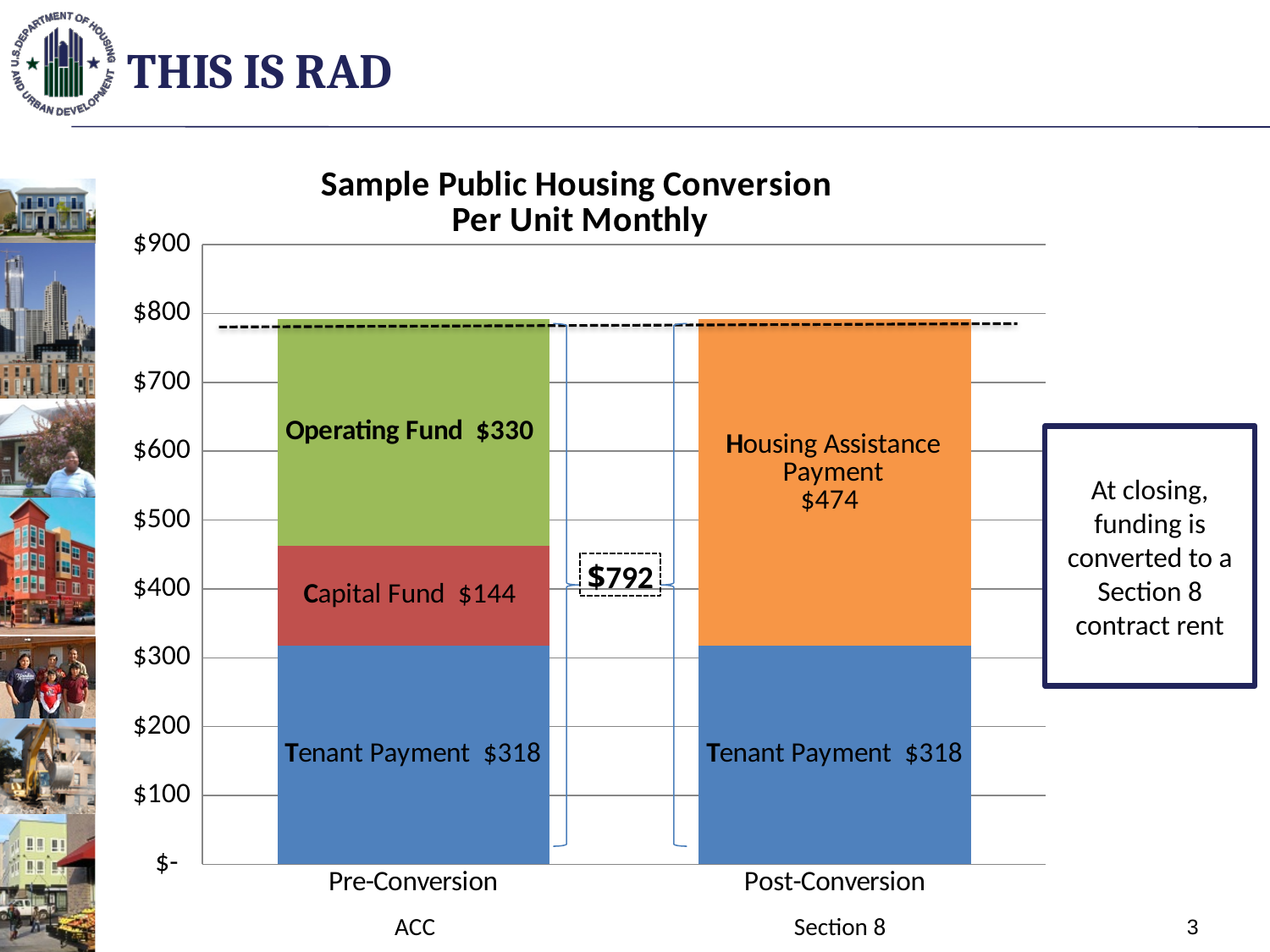
What is the Tenant Payment value in the Post-Conversion bar? $318 What kind of chart is shown on the slide? stacked bar chart Which segment of the Pre-Conversion bar is the smallest? Capital Fund What is the difference between the Operating Fund ($330) and the Capital Fund ($144) in the Pre-Conversion bar? $186 What is the Housing Assistance Payment value in the Post-Conversion bar? $474 What is the total of the Post-Conversion stacked bar? $792 What is the title of the chart? Sample Public Housing Conversion Per Unit Monthly Which is larger in the Post-Conversion bar: Housing Assistance Payment or Tenant Payment? Housing Assistance Payment What is the Capital Fund value in the Pre-Conversion bar? $144 How many bars (categories) are shown on the x axis? 2 What is the Operating Fund value in the Pre-Conversion bar? $330 What is the total of the Pre-Conversion stacked bar? $792